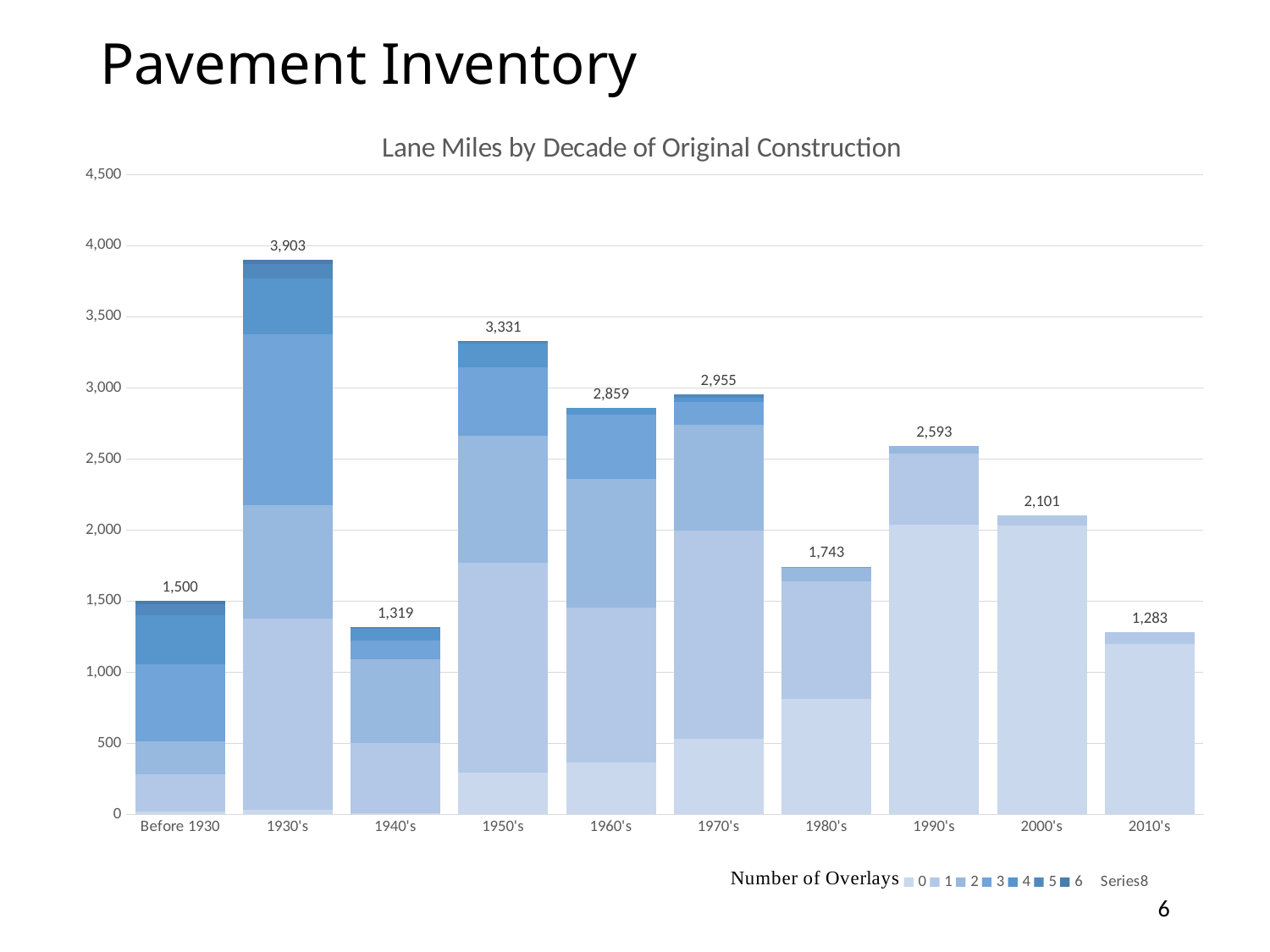
What is the difference between the total lane miles for the 1930's and the 1950's? 572 Which has more total lane miles, the 1960's or the 1970's? 1970's Which decade has the lowest total lane miles? 2010's Which decade has the highest total lane miles? 1930's What is the total lane miles value shown for the 1980's? 1,743 What is the total lane miles value shown for Before 1930? 1,500 How many decade categories are shown on the x axis? 10 What is the total lane miles value shown for the 1930's? 3,903 What kind of chart is shown on the slide? Stacked bar chart What is the difference between the total lane miles for the 1990's and the 2000's? 492 Do the total lane miles rise or fall from the 1970's to the 2010's? Fall Is the total value for the 1980's greater or less than 2,000? less